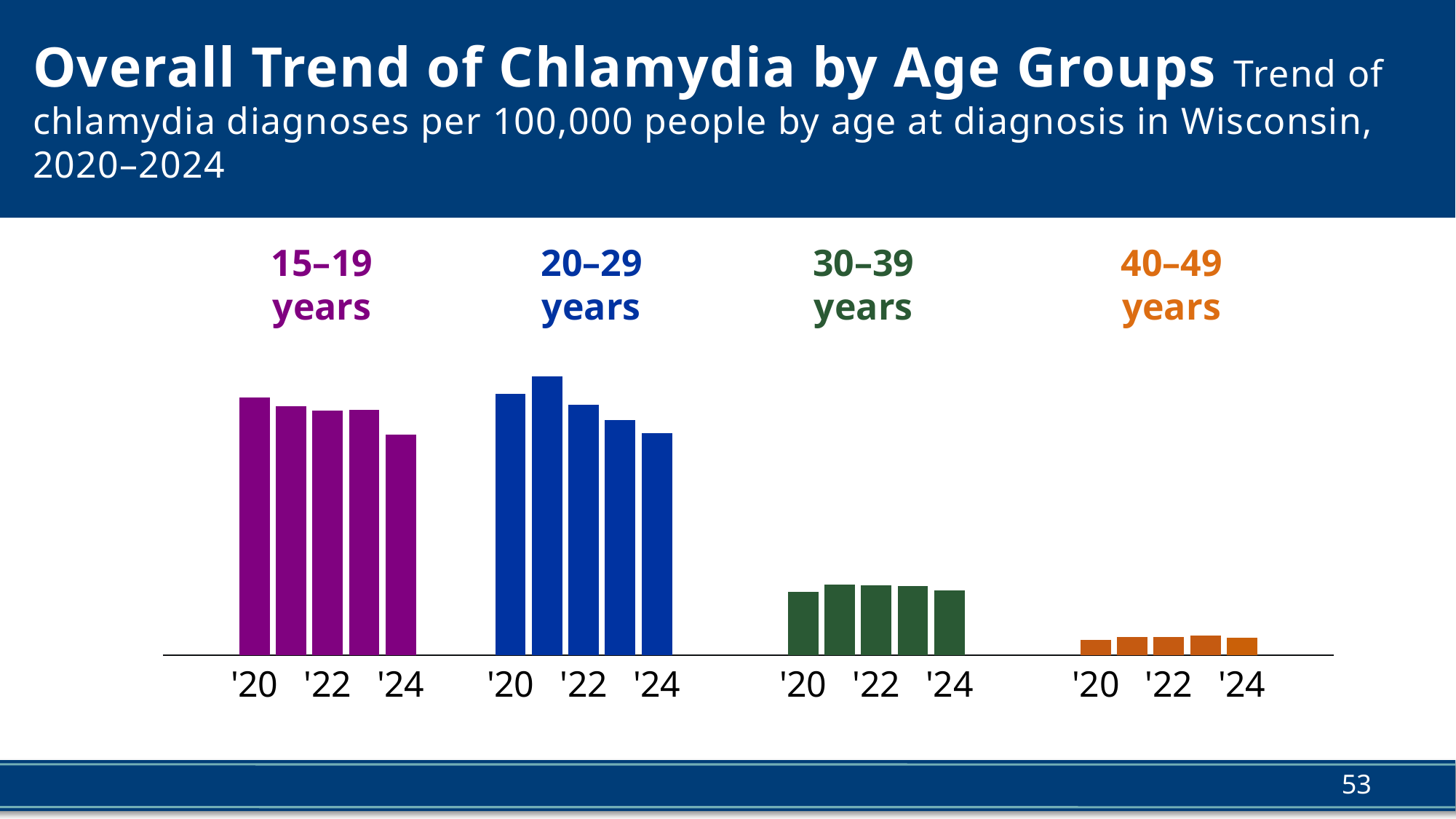
What colour are the bars for the 30–39 years age group? Green Which age group has the higher rate in 2024: 15–19 years or 30–39 years? 15–19 years For the 15–19 years group, do the rates rise or fall from 2020 to 2024? Fall How many age groups are shown in the chart? 4 How many bars are plotted for each age group? 5 For the 20–29 years group, in which year is the rate highest? 2021 Which age group has the higher rate in 2020: 20–29 years or 15–19 years? 20–29 years What years does the chart cover? 2020–2024 For the 20–29 years group, do the rates rise or fall from 2021 to 2024? Fall Which age group has the highest chlamydia diagnosis rates overall? 20–29 years Which age group has the lowest chlamydia diagnosis rates overall? 40–49 years What kind of chart is shown on the slide? Bar chart